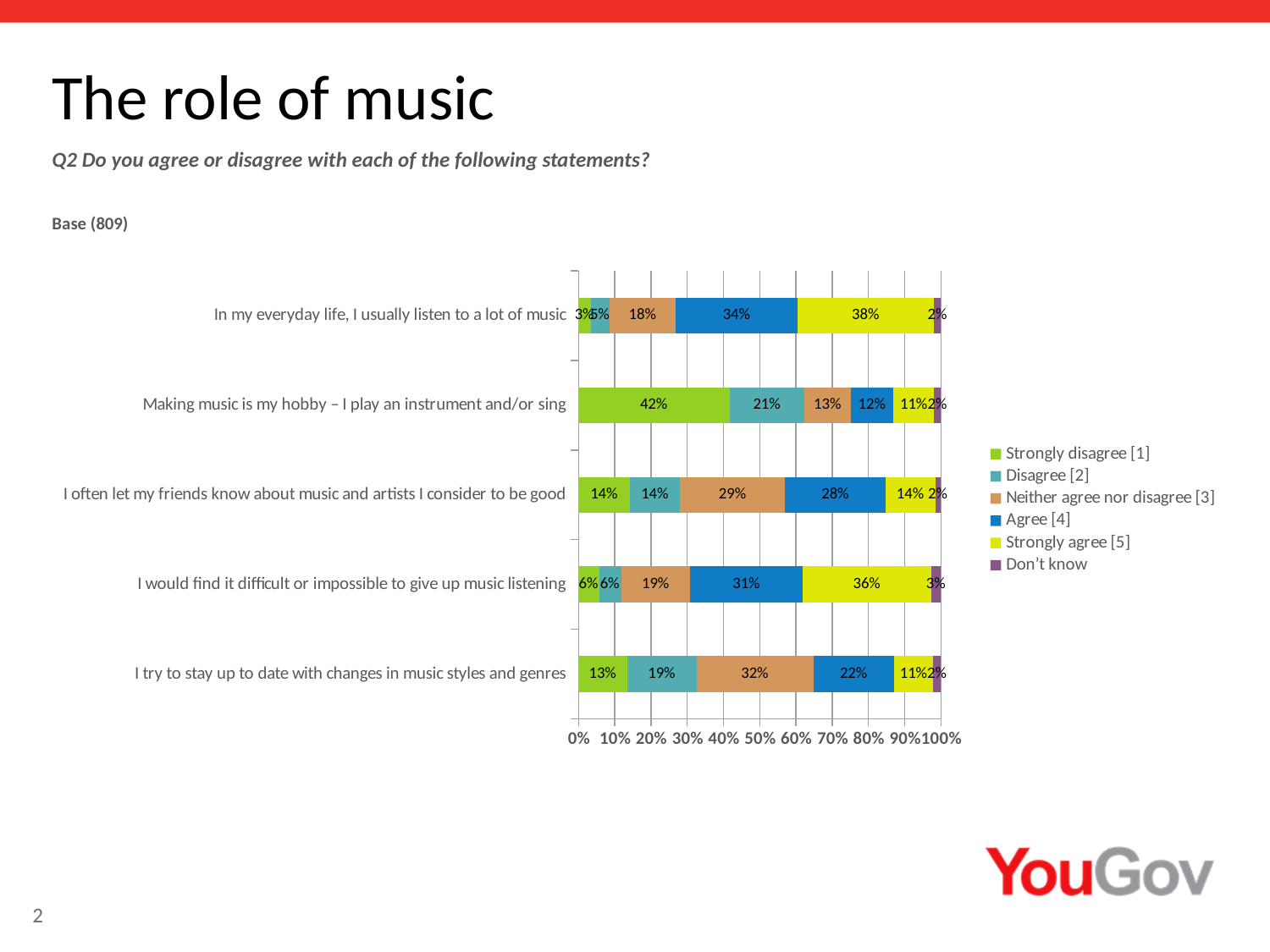
What is the difference between the "Strongly agree [5]" values for "In my everyday life, I usually listen to a lot of music" and "I would find it difficult or impossible to give up music listening"? 2% What percentage of respondents strongly agree that in their everyday life they usually listen to a lot of music? 38% What is the "Agree [4]" value for "I would find it difficult or impossible to give up music listening"? 31% What is the "Neither agree nor disagree [3]" value for "I try to stay up to date with changes in music styles and genres"? 32% What percentage strongly disagree with the statement "Making music is my hobby – I play an instrument and/or sing"? 42% Which statement has the highest "Strongly disagree [1]" value? Making music is my hobby – I play an instrument and/or sing What is the base size shown on the slide? 809 How many series does the legend list? 6 What kind of chart is shown on the slide? Stacked bar chart Which is larger: the "Agree [4]" value for "I often let my friends know about music and artists I consider to be good" or for "I try to stay up to date with changes in music styles and genres"? I often let my friends know about music and artists I consider to be good How many statements are shown in the chart? 5